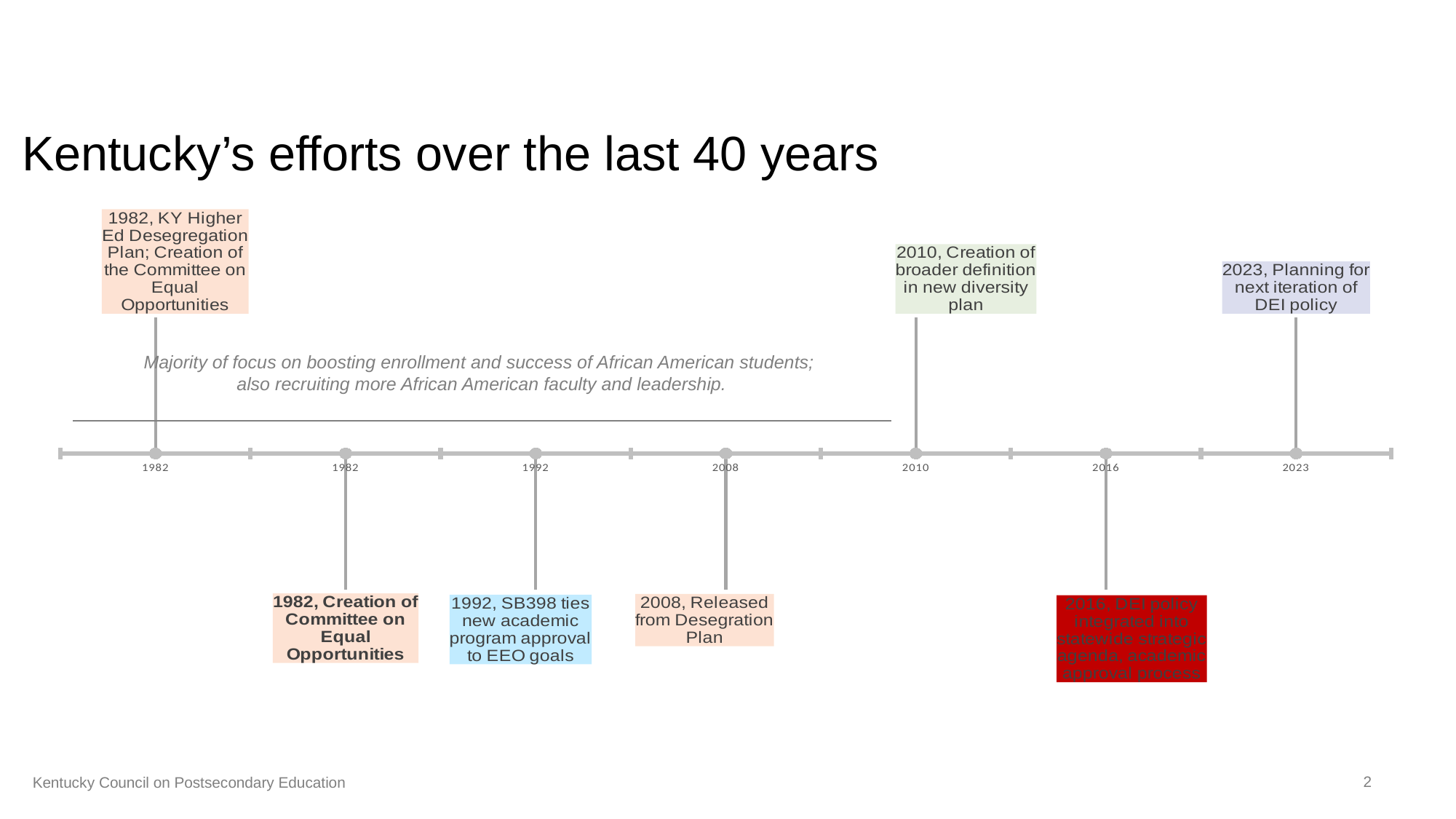
How many event markers are plotted on the timeline? 7 What is the earliest year labeled on the timeline? 1982 What is the latest year labeled on the timeline? 2023 In which year was Kentucky released from the Desegregation Plan, according to the timeline? 2008 What event is shown on the timeline for 2023? Planning for next iteration of DEI policy How many years separate the 1992 marker and the 2008 marker on the timeline? 16 Do the years on the timeline increase or decrease from left to right? Increase How many years separate the first marker (1982) and the last marker (2023) on the timeline? 41 What event is shown on the timeline for 2010? Creation of broader definition in new diversity plan Which year on the timeline is labeled with SB398 tying new academic program approval to EEO goals? 1992 What is the title of the slide? Kentucky's efforts over the last 40 years What kind of chart is shown on the slide? Timeline